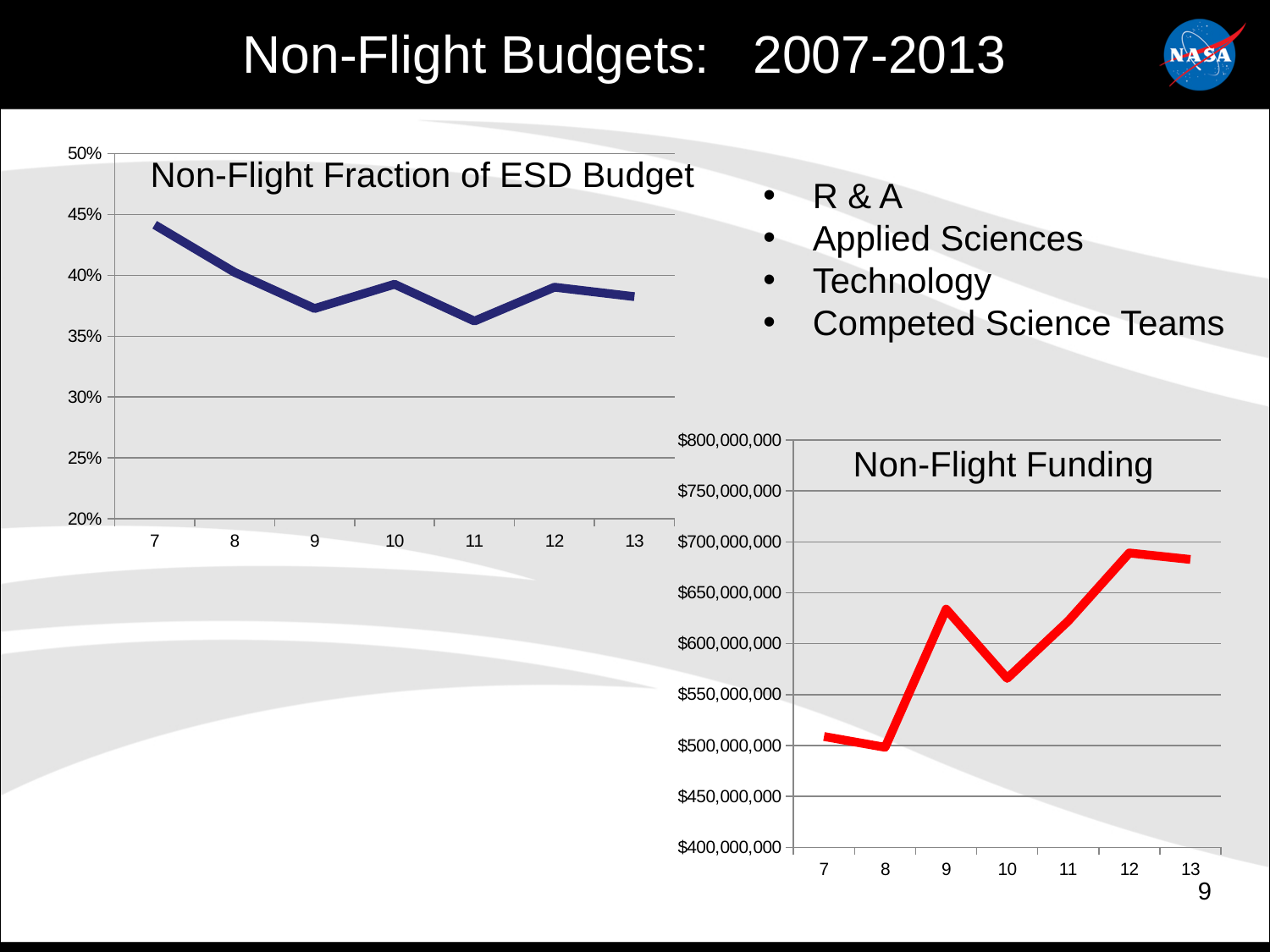
In the 'Non-Flight Fraction of ESD Budget' chart, does the value overall rise or fall from year 7 to year 13? fall In the 'Non-Flight Funding' chart, is the value for year 12 greater or less than $650,000,000? greater In the 'Non-Flight Funding' chart, is the value for year 9 greater or less than $600,000,000? greater In the 'Non-Flight Fraction of ESD Budget' chart, which year has the lowest value? 11 What kind of chart is the 'Non-Flight Funding' chart? line chart In the 'Non-Flight Fraction of ESD Budget' chart, is the value for year 11 greater or less than 40%? less In the 'Non-Flight Funding' chart, does the value overall rise or fall from year 7 to year 13? rise In the 'Non-Flight Fraction of ESD Budget' chart, which year has the highest value? 7 What kind of chart is the 'Non-Flight Fraction of ESD Budget' chart? line chart In the 'Non-Flight Fraction of ESD Budget' chart, how many data points are plotted? 7